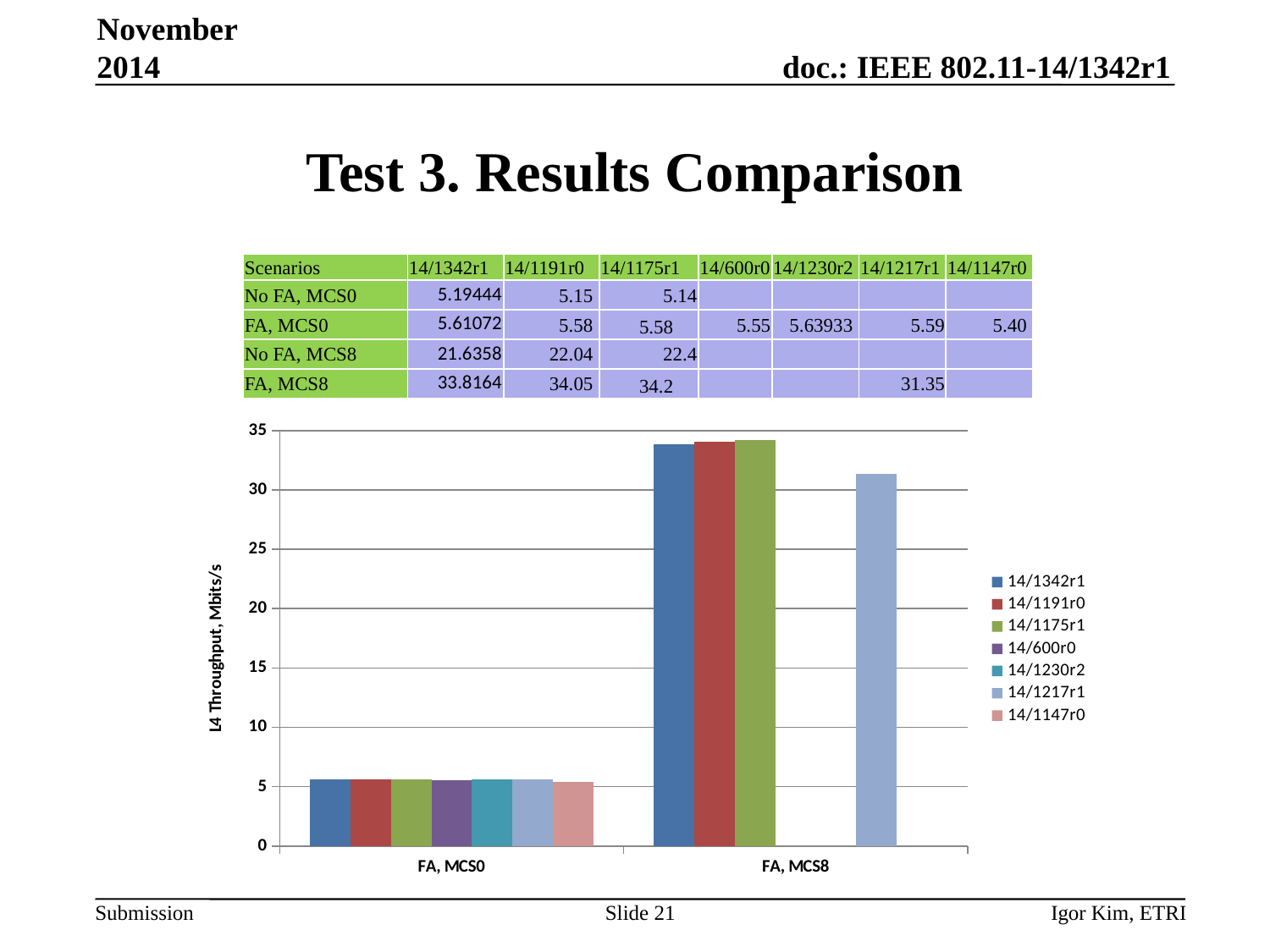
Is the value for 14/1342r1 in the FA, MCS8 category greater or less than 30? greater What type of chart is shown on the slide? bar chart In the FA, MCS8 category, which series has the lowest bar? 14/1217r1 What is the label of the chart's y axis? L4 Throughput, Mbits/s According to the table, what is the value for 14/1147r0 in the FA, MCS0 scenario? 5.40 According to the table, what is the value for 14/1217r1 in the FA, MCS8 scenario? 31.35 Is the value for 14/1217r1 in the FA, MCS8 category greater or less than 35? less How many series have a bar plotted in the FA, MCS8 category? 4 How many series does the chart legend list? 7 How many categories are shown on the x axis of the chart? 2 In the FA, MCS8 category, which is larger: 14/1175r1 or 14/1217r1? 14/1175r1 Is the value for 14/1342r1 in the FA, MCS0 category greater or less than 10? less